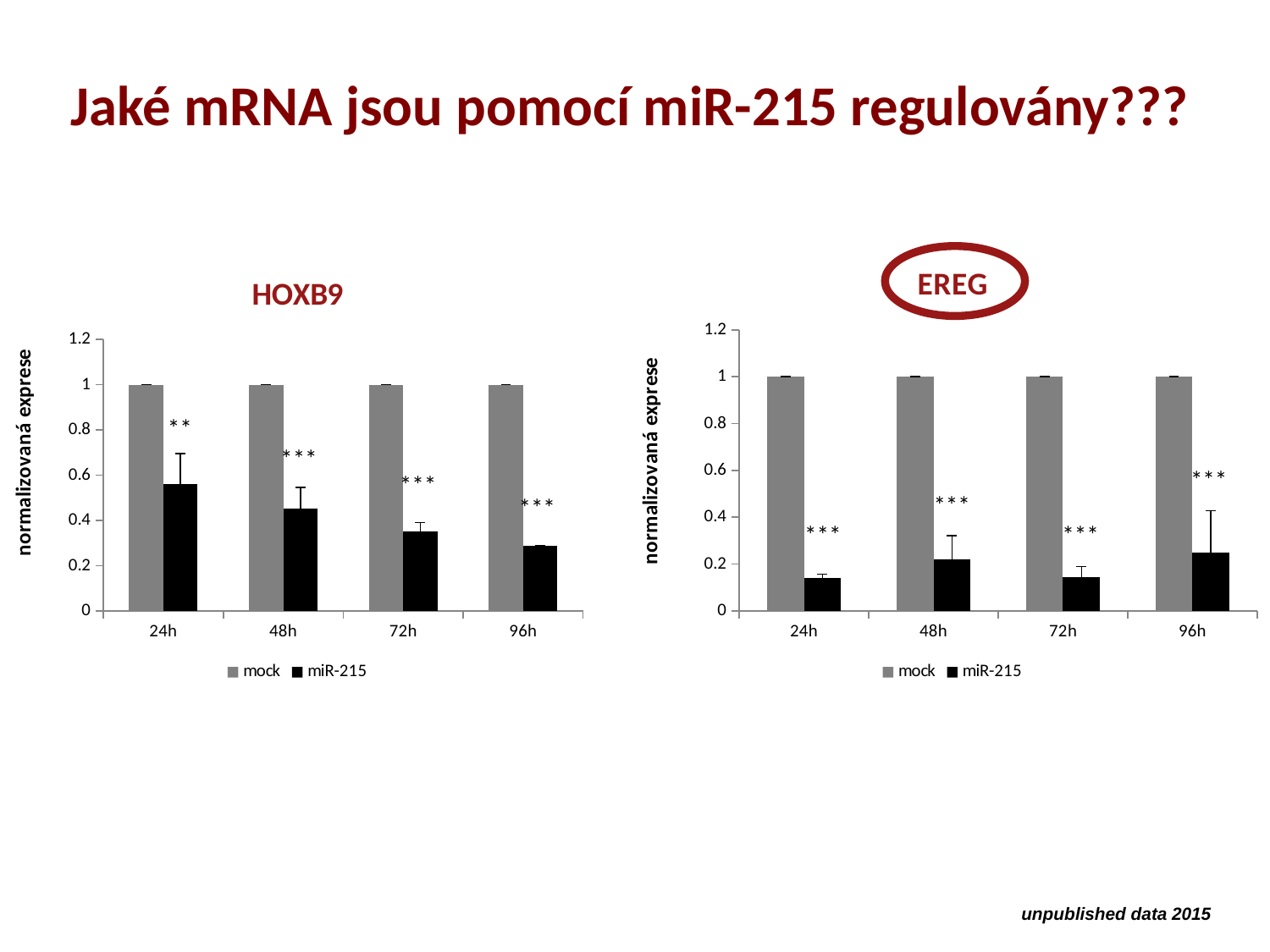
In the HOXB9 chart, do the miR-215 values rise or fall from 24h to 96h? fall How many series does the legend of the HOXB9 chart list? 2 In the HOXB9 chart, what is the value of the mock bar at 24h? 1 What are the two legend entries in the EREG chart? mock and miR-215 What kind of chart is the HOXB9 chart? bar chart In the EREG chart, what is the value of the mock bar at 96h? 1 In the HOXB9 chart, is the miR-215 value at 24h greater or less than 0.4? greater In the HOXB9 chart, is the miR-215 value at 96h greater or less than 0.4? less In the HOXB9 chart, at which time point is the miR-215 bar highest? 24h How many time-point categories are shown on the x axis of the EREG chart? 4 In the EREG chart, is the miR-215 value at 24h greater or less than 0.2? less In the HOXB9 chart, at which time point is the miR-215 bar lowest? 96h